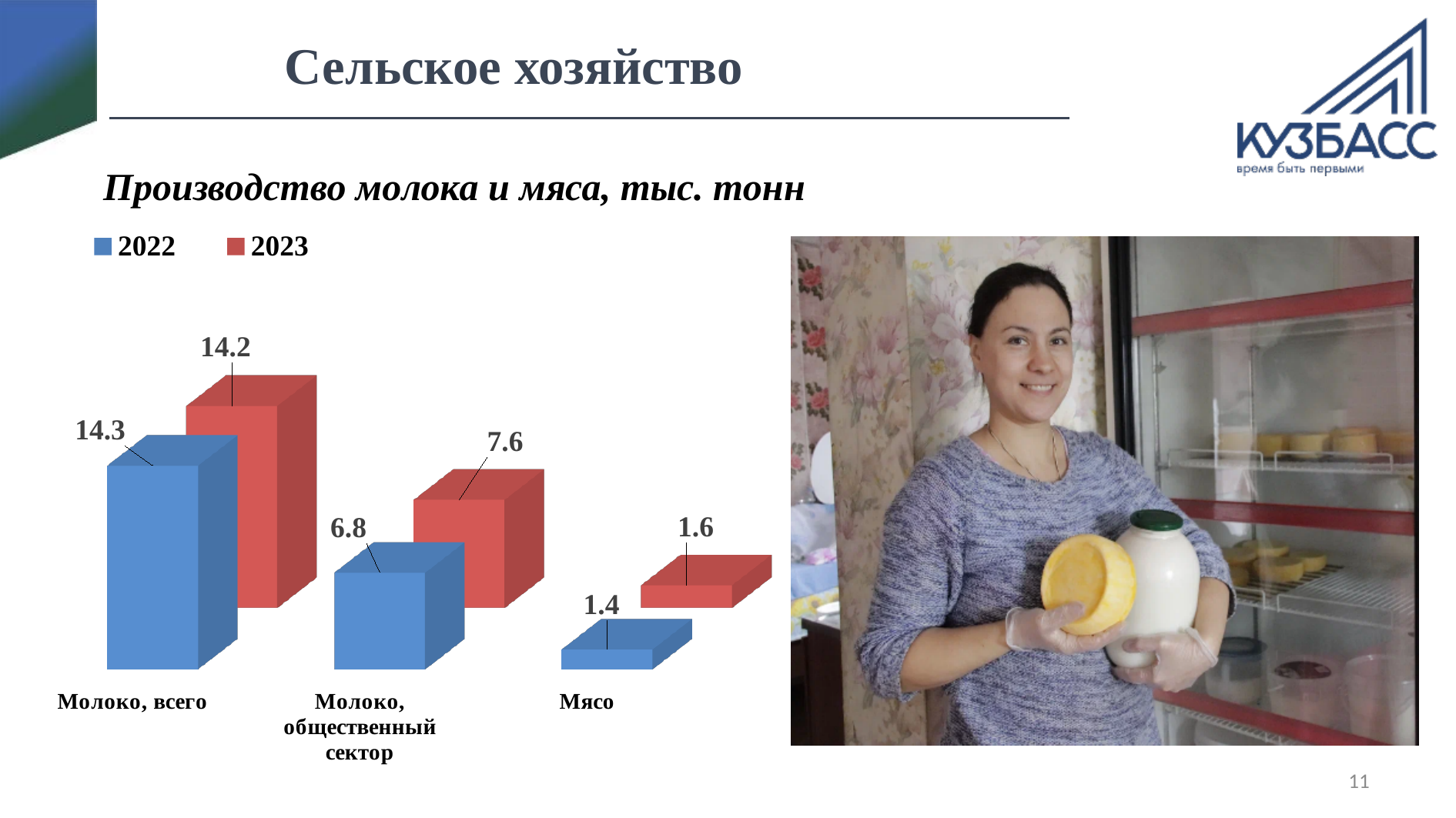
How many categories are shown on the chart? 3 Which category has the highest 2023 value? Молоко, всего What is the 2023 value for Мясо? 1.6 What is the 2022 value for Мясо? 1.4 How many series does the legend list? 2 What is the difference between the 2022 and 2023 values for Молоко, всего? 0.1 What is the difference between the 2023 and 2022 values for Молоко, общественный сектор? 0.8 What is the 2023 value for Молоко, общественный сектор? 7.6 What kind of chart is shown on the slide? Bar chart For Мясо, which year has the larger value, 2022 or 2023? 2023 What is the 2022 value for Молоко, всего? 14.3 Which category has the lowest 2022 value? Мясо